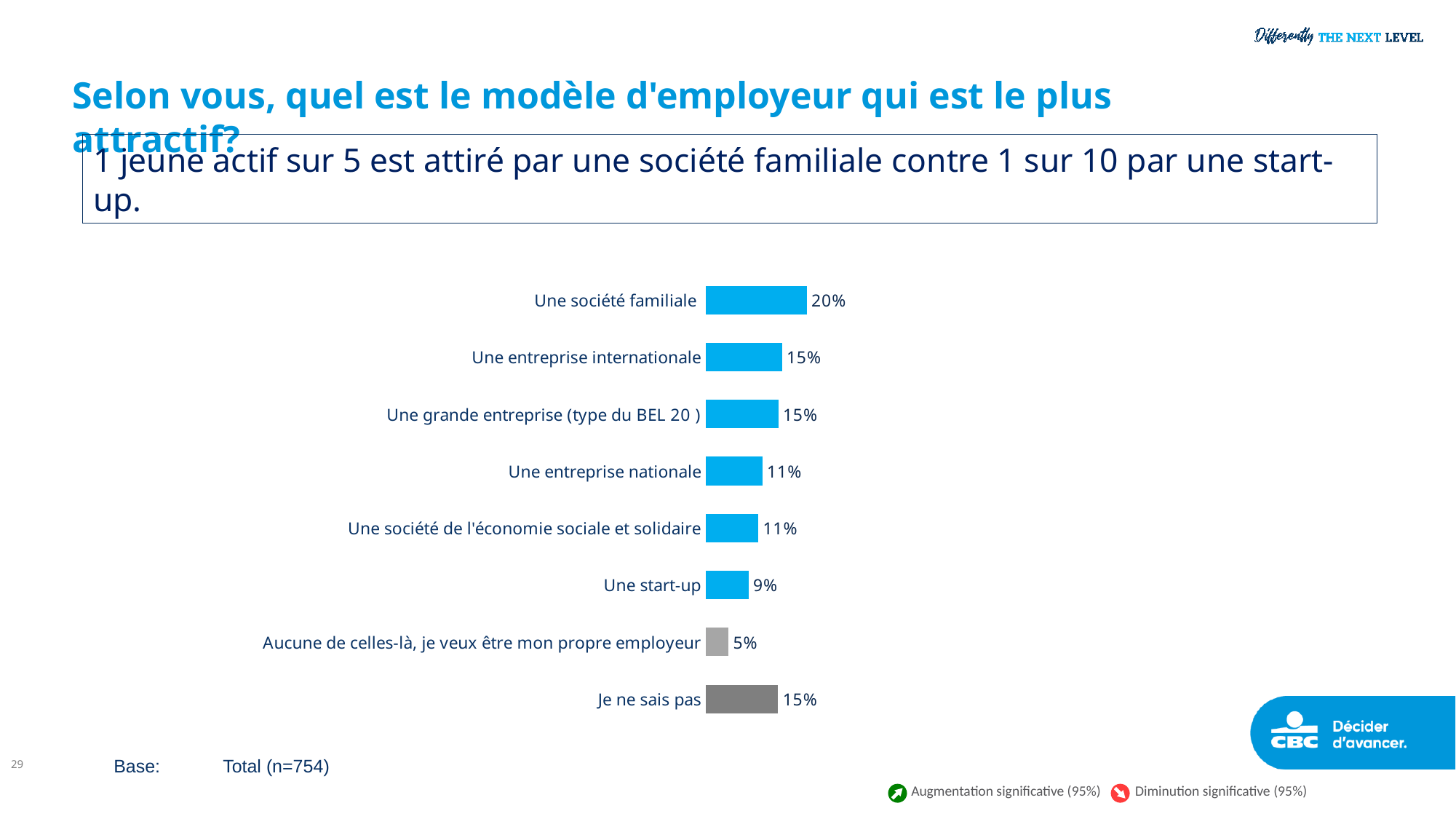
What is the value for "Aucune de celles-là, je veux être mon propre employeur"? 5% What is the value for "Une start-up"? 9% What is the value for "Une société familiale"? 20% What is the difference between the values for "Une entreprise internationale" and "Une entreprise nationale"? 4% What is the value for "Je ne sais pas"? 15% What is the difference between the values for "Une société familiale" and "Une start-up"? 11% What kind of chart is shown on the slide? Bar chart What is the value for "Une entreprise nationale"? 11% Which category has the lowest value? Aucune de celles-là, je veux être mon propre employeur Which is larger, the value for "Une grande entreprise (type du BEL 20 )" or the value for "Une société de l'économie sociale et solidaire"? Une grande entreprise (type du BEL 20 ) How many categories are shown in the chart? 8 Which category has the highest value? Une société familiale